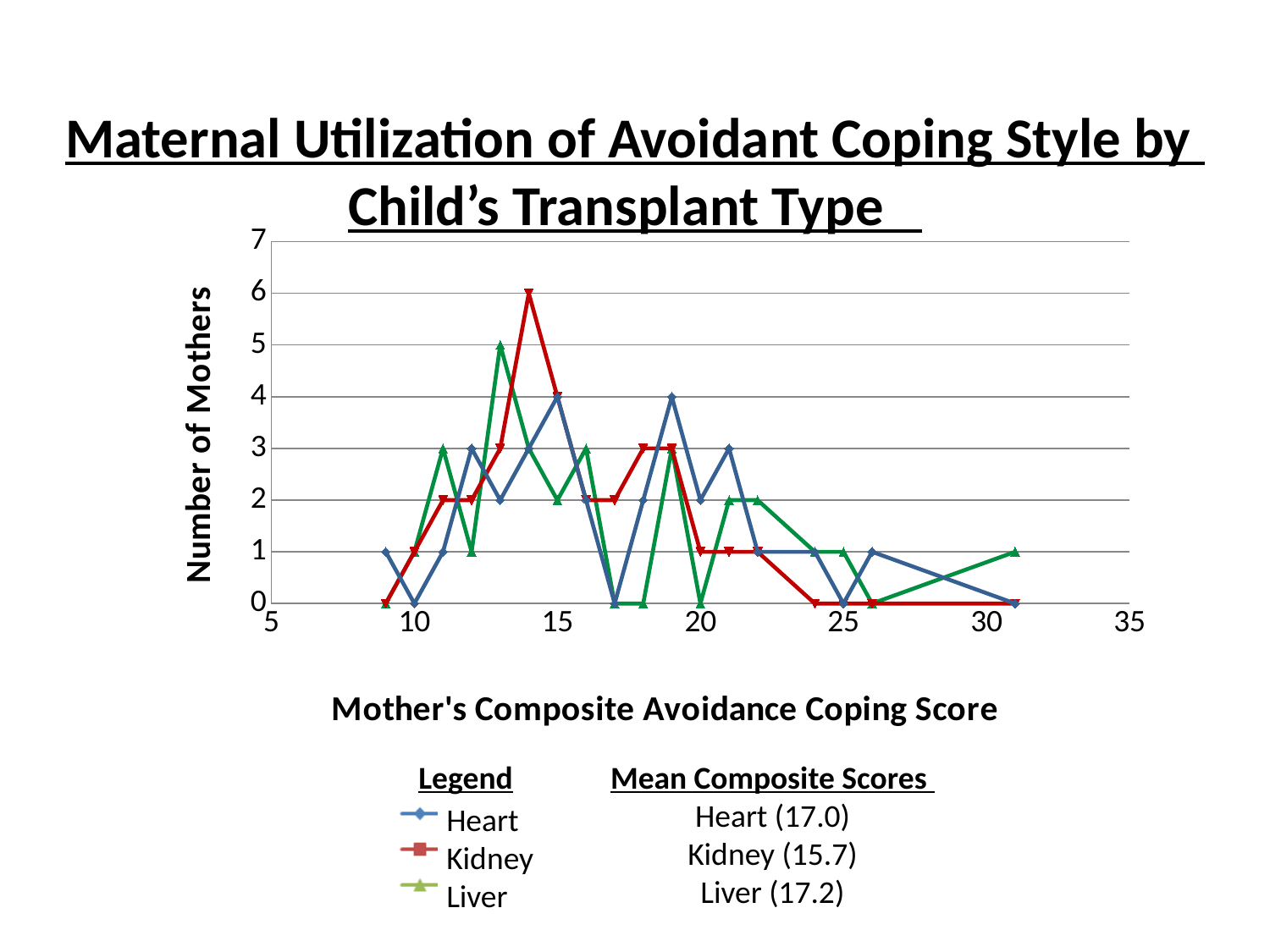
What is the highest number of mothers reached by the Liver series? 5 Which series has the lowest peak value on the chart? Heart What is the title of the vertical axis? Number of Mothers How many series does the legend list? 3 Is the peak value of the Kidney series greater or less than 5? greater What kind of chart is shown on the slide? line chart Which series reaches the highest peak on the chart? Kidney What is the difference between the peak value of the Kidney series and the peak value of the Liver series? 1 What is the title of the horizontal axis? Mother's Composite Avoidance Coping Score What is the highest number of mothers reached by the Heart series? 4 What is the highest number of mothers reached by the Kidney series? 6 Is the peak value of the Heart series greater or less than 5? less